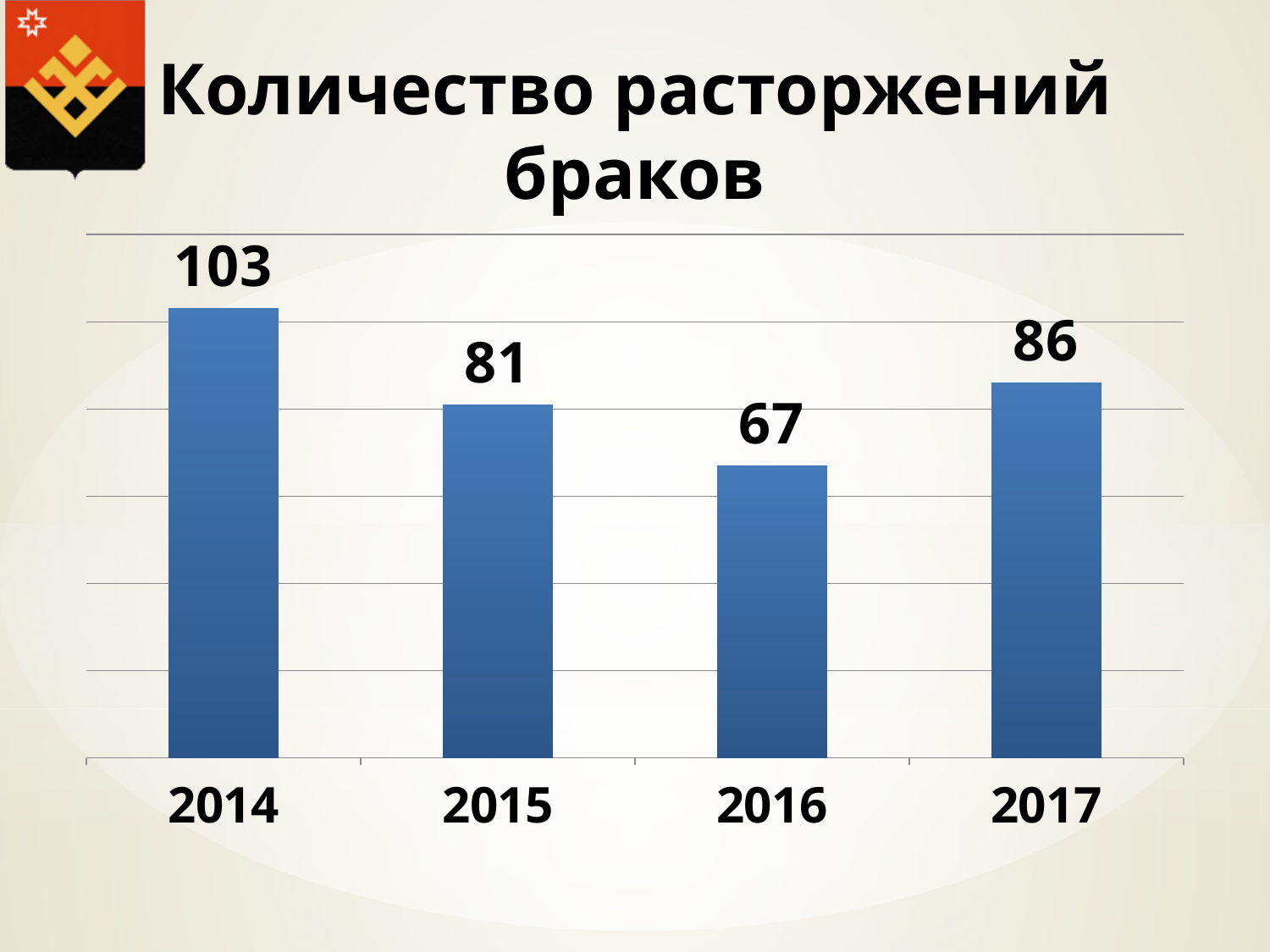
What is the number of divorces in 2014? 103 How many years are shown on the chart? 4 What kind of chart is shown on the slide? Bar chart Which year has the highest number of divorces? 2014 What is the number of divorces in 2015? 81 What is the difference between the values for 2017 and 2015? 5 What is the difference between the values for 2014 and 2016? 36 Which year has the lowest number of divorces? 2016 What is the number of divorces in 2016? 67 What is the title of the chart? Количество расторжений браков Which year has a larger value, 2015 or 2017? 2017 What is the number of divorces in 2017? 86